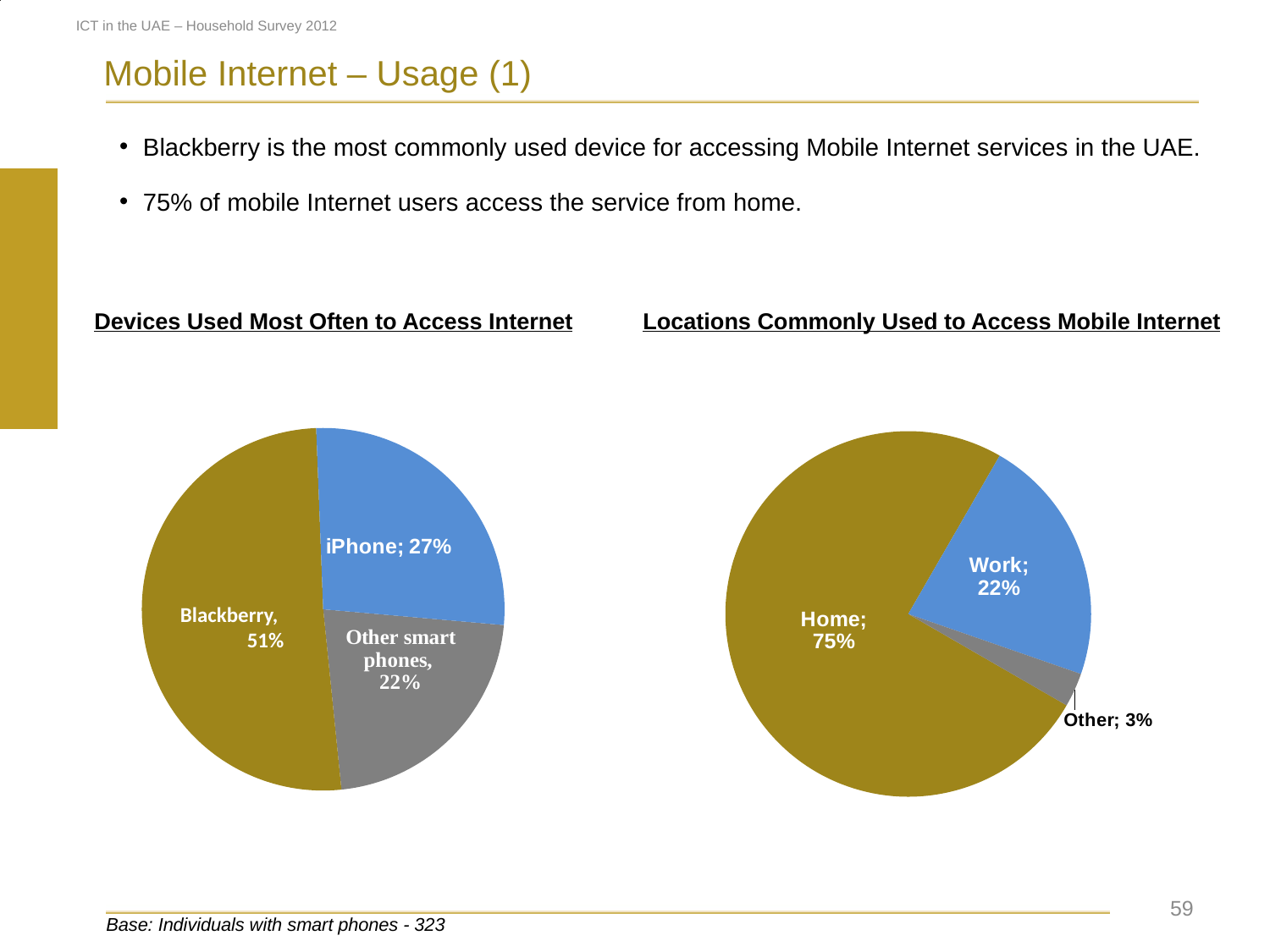
In the 'Devices Used Most Often to Access Internet' chart, how many slices does the pie have? 3 In the 'Devices Used Most Often to Access Internet' chart, what share is Blackberry? 51% What type of chart is the 'Locations Commonly Used to Access Mobile Internet' chart? Pie chart In the 'Devices Used Most Often to Access Internet' chart, what share is Other smart phones? 22% In the 'Devices Used Most Often to Access Internet' chart, what is the difference between the Blackberry and iPhone shares? 24% In the 'Locations Commonly Used to Access Mobile Internet' chart, what share is Work? 22% In the 'Locations Commonly Used to Access Mobile Internet' chart, which is larger, Work or Other? Work In the 'Locations Commonly Used to Access Mobile Internet' chart, what share is Home? 75% In the 'Locations Commonly Used to Access Mobile Internet' chart, what is the difference between the Home and Work shares? 53% In the 'Devices Used Most Often to Access Internet' chart, which device has the largest share? Blackberry In the 'Devices Used Most Often to Access Internet' chart, what share is iPhone? 27% In the 'Locations Commonly Used to Access Mobile Internet' chart, which location has the smallest share? Other